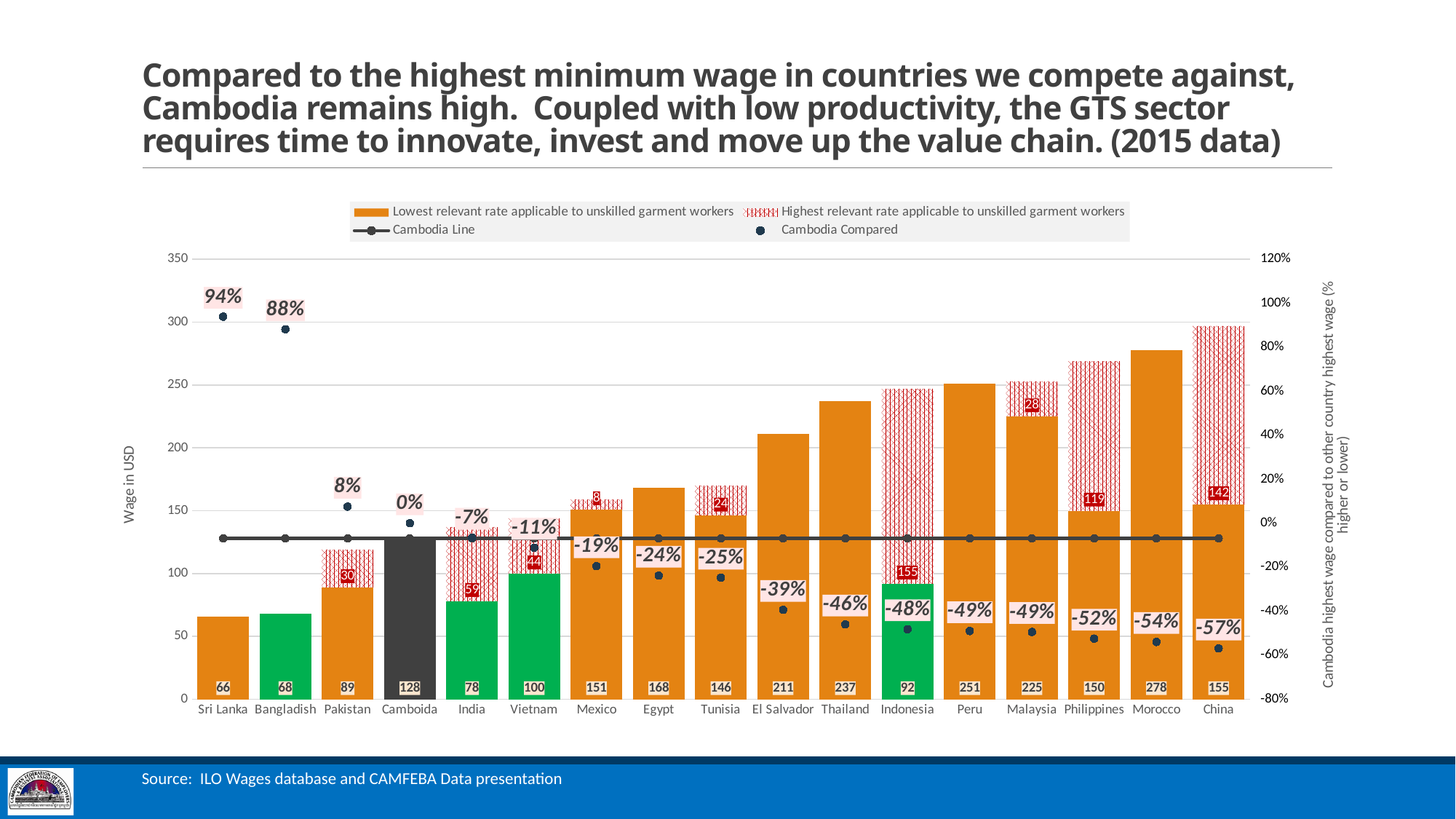
What is the Cambodia Compared value for Sri Lanka? 94% What kind of chart is used to show the wages? Bar chart Which has a higher lowest relevant rate, Egypt or Tunisia? Egypt What is the total height of the stacked bar for Indonesia (lowest rate plus highest rate increment)? 247 How many countries are shown on the x axis? 17 What is the lowest relevant rate applicable to unskilled garment workers for Morocco? 278 How many series does the legend list? 4 What is the Cambodia Compared value for China? -57% What is the difference between the lowest relevant rate for Morocco and for Camboida? 150 Which country has the highest lowest relevant rate applicable to unskilled garment workers? Morocco Which country has the lowest lowest relevant rate applicable to unskilled garment workers? Sri Lanka What is the title of the left vertical axis? Wage in USD